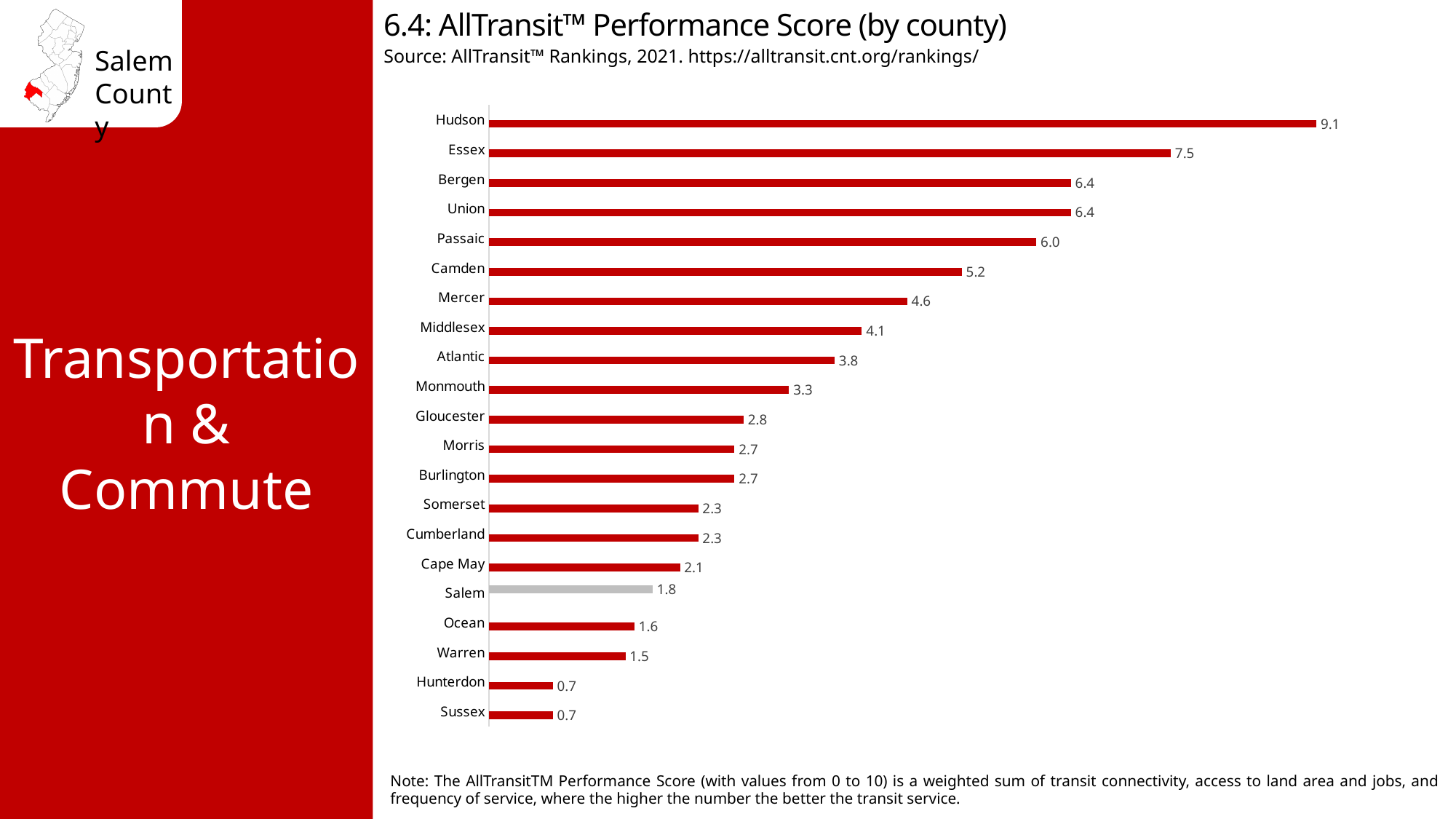
Which county has a higher AllTransit Performance Score, Ocean or Salem? Salem How many counties are shown in the chart? 21 What is the difference between the AllTransit Performance Scores of Hudson and Essex counties? 1.6 What is the AllTransit Performance Score for Salem County? 1.8 What is the source of the data shown in the chart? AllTransit™ Rankings, 2021 Which county has the highest AllTransit Performance Score? Hudson What is the AllTransit Performance Score for Camden County? 5.2 Which county's bar is shown in grey rather than red? Salem Which county has a higher AllTransit Performance Score, Passaic or Camden? Passaic What type of chart is used to show the AllTransit Performance Score by county? Bar chart What is the difference between the AllTransit Performance Scores of Cape May and Salem counties? 0.3 What is the AllTransit Performance Score for Mercer County? 4.6